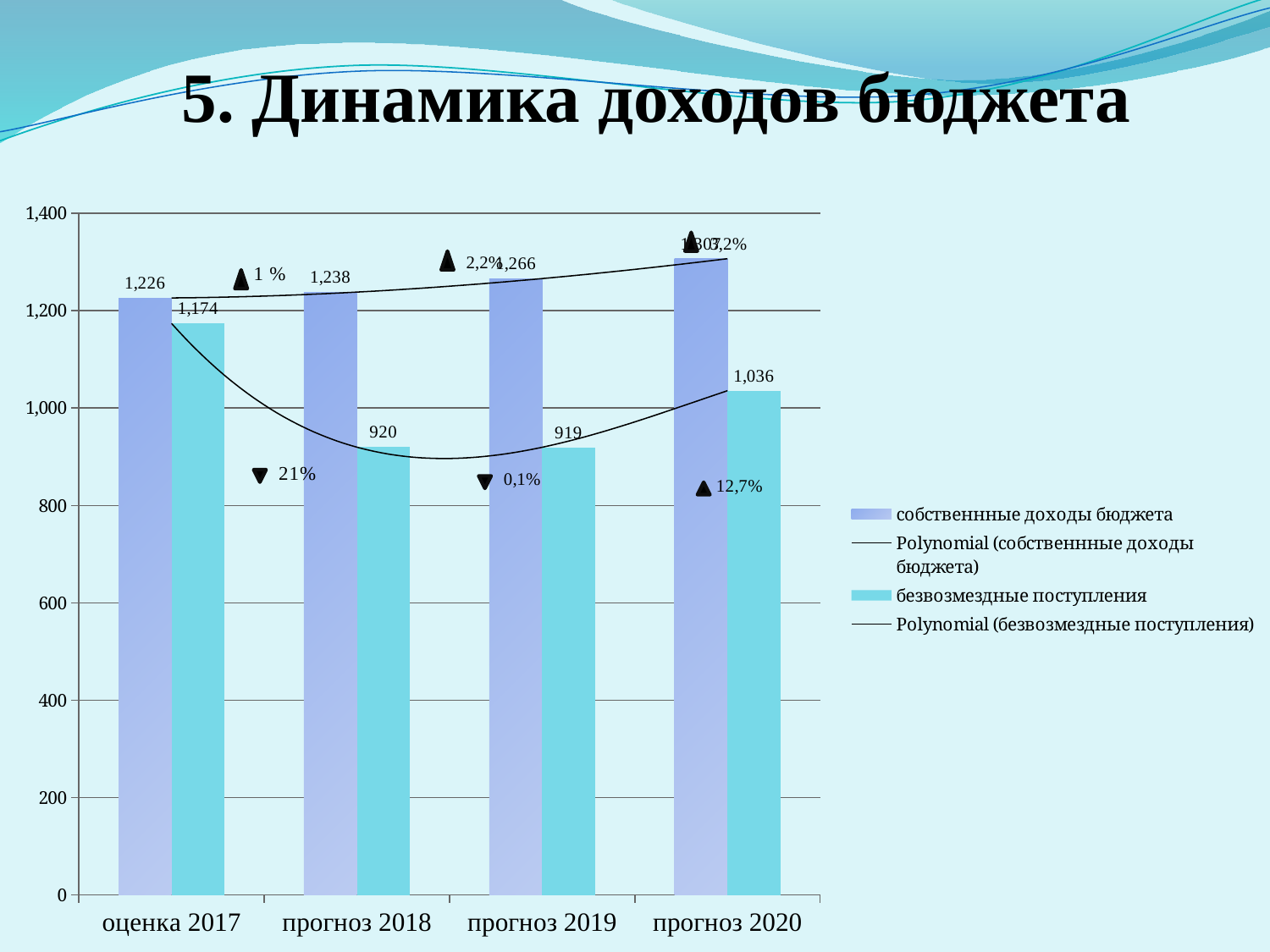
What is the value of собственнные доходы бюджета for прогноз 2019? 1,266 How many entries does the legend list? 4 How many categories are shown on the x axis? 4 What kind of chart is shown on the slide? bar chart What is the value of собственнные доходы бюджета for оценка 2017? 1,226 What is the value of безвозмездные поступления for прогноз 2018? 920 What is the difference between безвозмездные поступления for оценка 2017 and прогноз 2018? 254 What is the value of безвозмездные поступления for прогноз 2020? 1,036 In which category is безвозмездные поступления highest? оценка 2017 For прогноз 2019, which is larger: собственнные доходы бюджета or безвозмездные поступления? собственнные доходы бюджета Do the values of собственнные доходы бюджета rise or fall from оценка 2017 to прогноз 2020? rise Is the value of собственнные доходы бюджета for прогноз 2020 greater or less than 1,200? greater